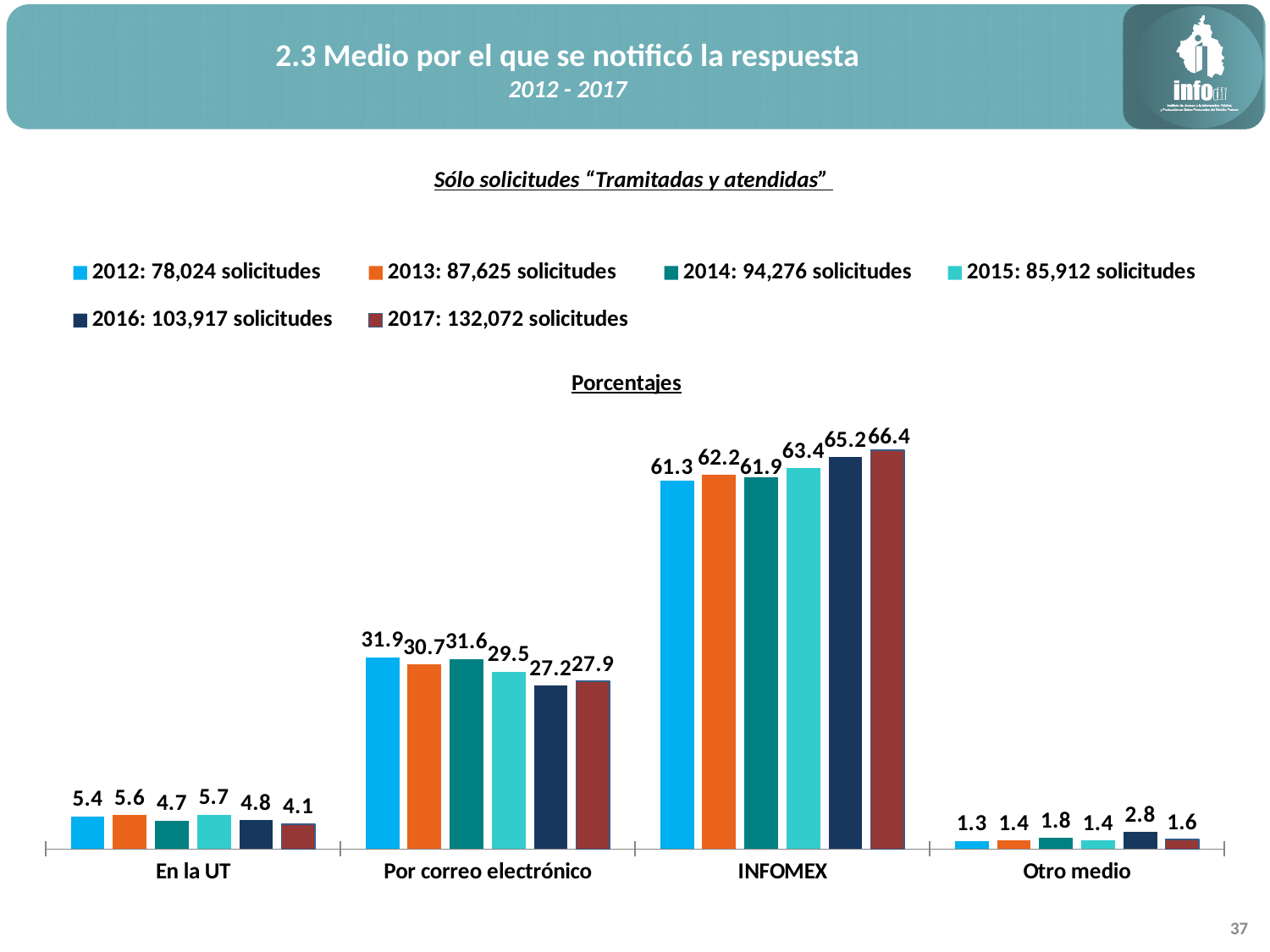
How many series does the legend list? 6 According to the legend, how many solicitudes were there in 2017? 132,072 Which category has the highest value in the 2015 series? INFOMEX What is the value for Por correo electrónico in the 2012 series? 31.9 What is the value for Otro medio in the 2016 series? 2.8 What kind of chart is shown on the slide? bar chart What is the value for En la UT in the 2014 series? 4.7 Which category has the lowest value in the 2013 series? Otro medio What is the difference between the 2017 and 2012 values for INFOMEX? 5.1 Which is larger for Por correo electrónico: the 2016 value or the 2017 value? 2017 How many categories are shown on the x axis? 4 What is the value for INFOMEX in the 2017 series? 66.4